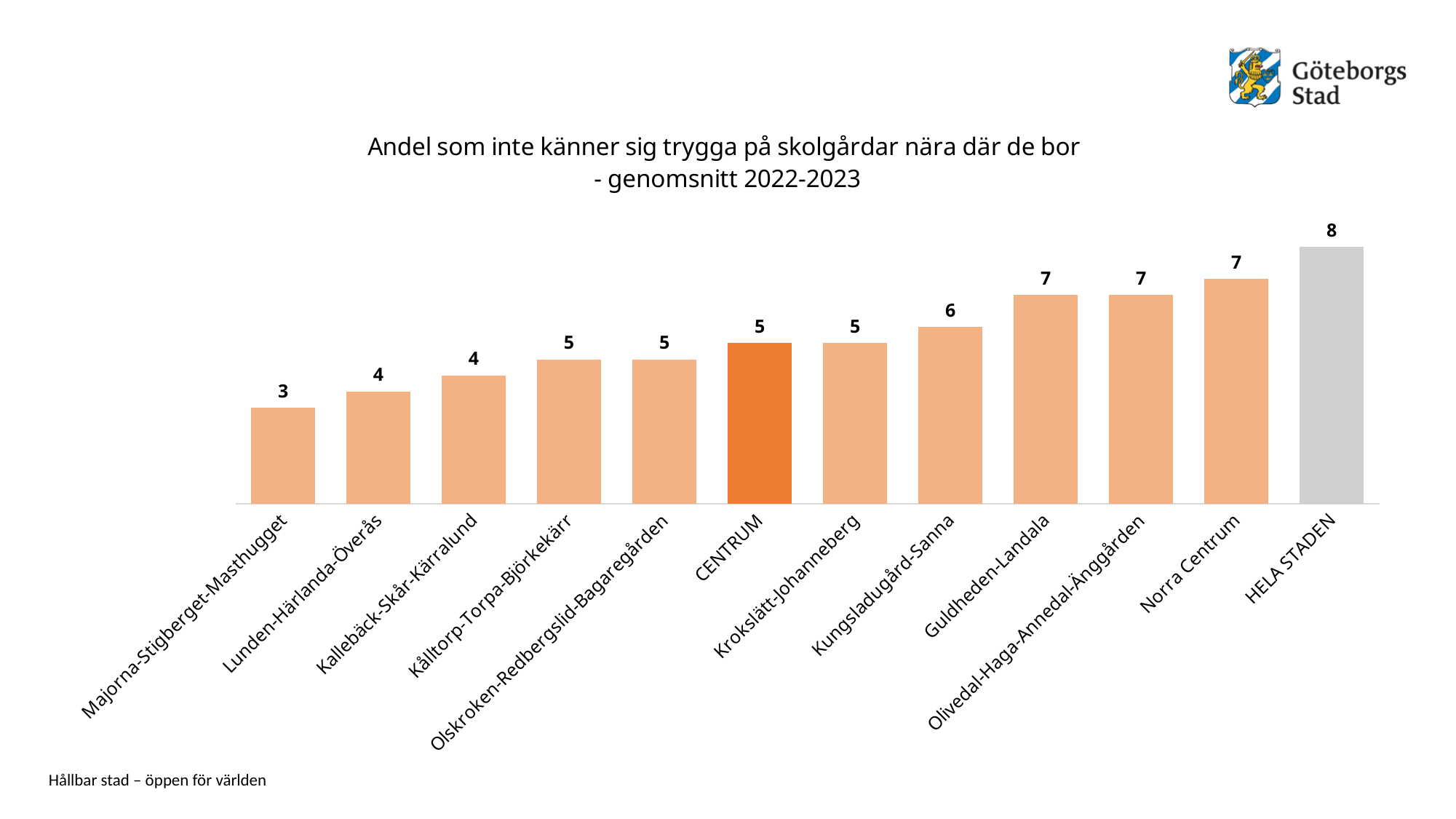
What is the value for HELA STADEN? 8 How many categories are shown on the x axis? 12 What kind of chart is this? Bar chart What is the value for Majorna-Stigberget-Masthugget? 3 Which category has the lowest value? Majorna-Stigberget-Masthugget What is the value for CENTRUM? 5 What is the title of the chart? Andel som inte känner sig trygga på skolgårdar nära där de bor - genomsnitt 2022-2023 Which category has the highest value? HELA STADEN What is the value for Guldheden-Landala? 7 Do the values rise or fall from left to right along the x axis? Rise What is the difference between the values for HELA STADEN and CENTRUM? 3 Which is larger, the value for Norra Centrum or the value for Kungsladugård-Sanna? Norra Centrum